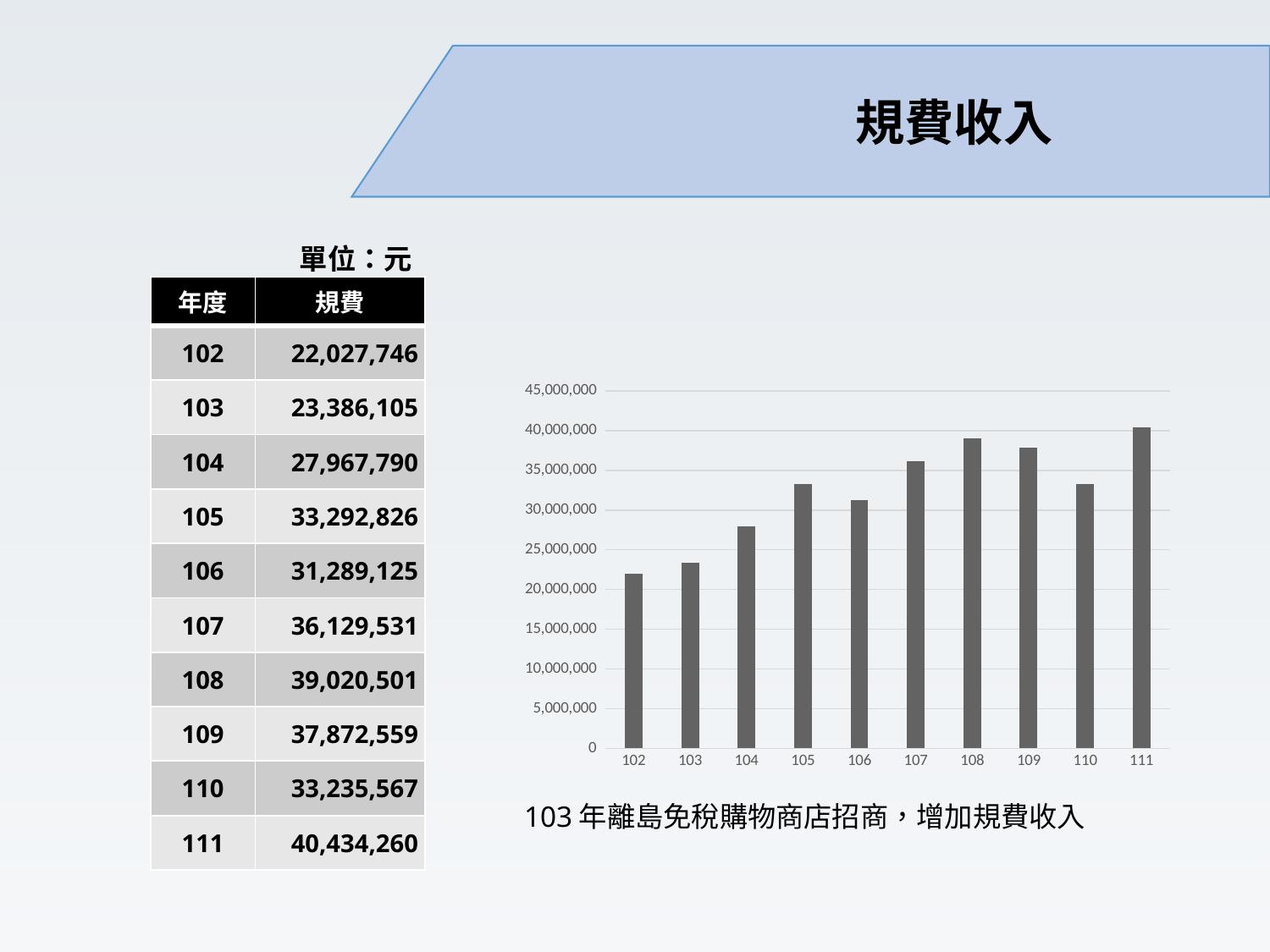
What is the highest value shown on the chart's vertical axis? 45,000,000 Is the value for year 102 greater or less than 25,000,000? less According to the table on the slide, what is the 規費 value for year 111? 40,434,260 How many years (categories) are plotted on the x axis of the chart? 10 According to the table on the slide, what is the 規費 value for year 107? 36,129,531 What kind of chart is shown on the slide? bar chart Is the value for year 106 greater or less than 30,000,000? greater Is the value for year 111 greater or less than 40,000,000? greater Which year has the highest bar in the chart? 111 Which year has the lowest bar in the chart? 102 Which is larger, the bar for year 108 or the bar for year 109? 108 Which is larger, the bar for year 105 or the bar for year 106? 105